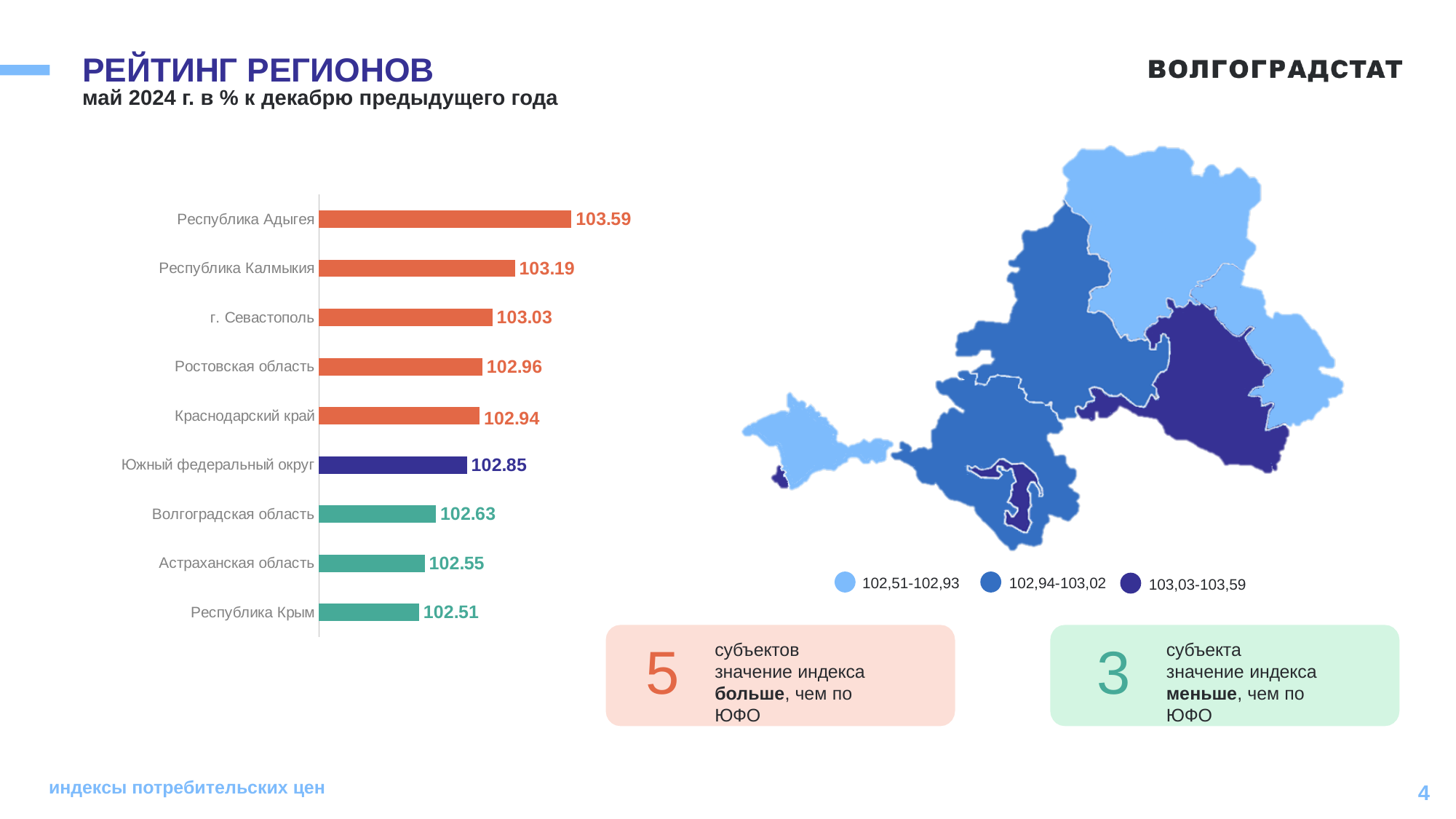
What is the difference between the values for Республика Адыгея and Республика Крым? 1.08 What is the value for Республика Адыгея? 103.59 What kind of chart is shown on the left of the slide? Bar chart How many regions (bars) are shown in the bar chart? 9 Which region has the highest value in the bar chart? Республика Адыгея Which is larger, the value for Республика Калмыкия or the value for Астраханская область? Республика Калмыкия What is the value for Волгоградская область? 102.63 What is the value for Южный федеральный округ? 102.85 What is the value for г. Севастополь? 103.03 What is the difference between the values for Южный федеральный округ and Волгоградская область? 0.22 Which region has the lowest value in the bar chart? Республика Крым What is the subtitle under the chart title РЕЙТИНГ РЕГИОНОВ? май 2024 г. в % к декабрю предыдущего года